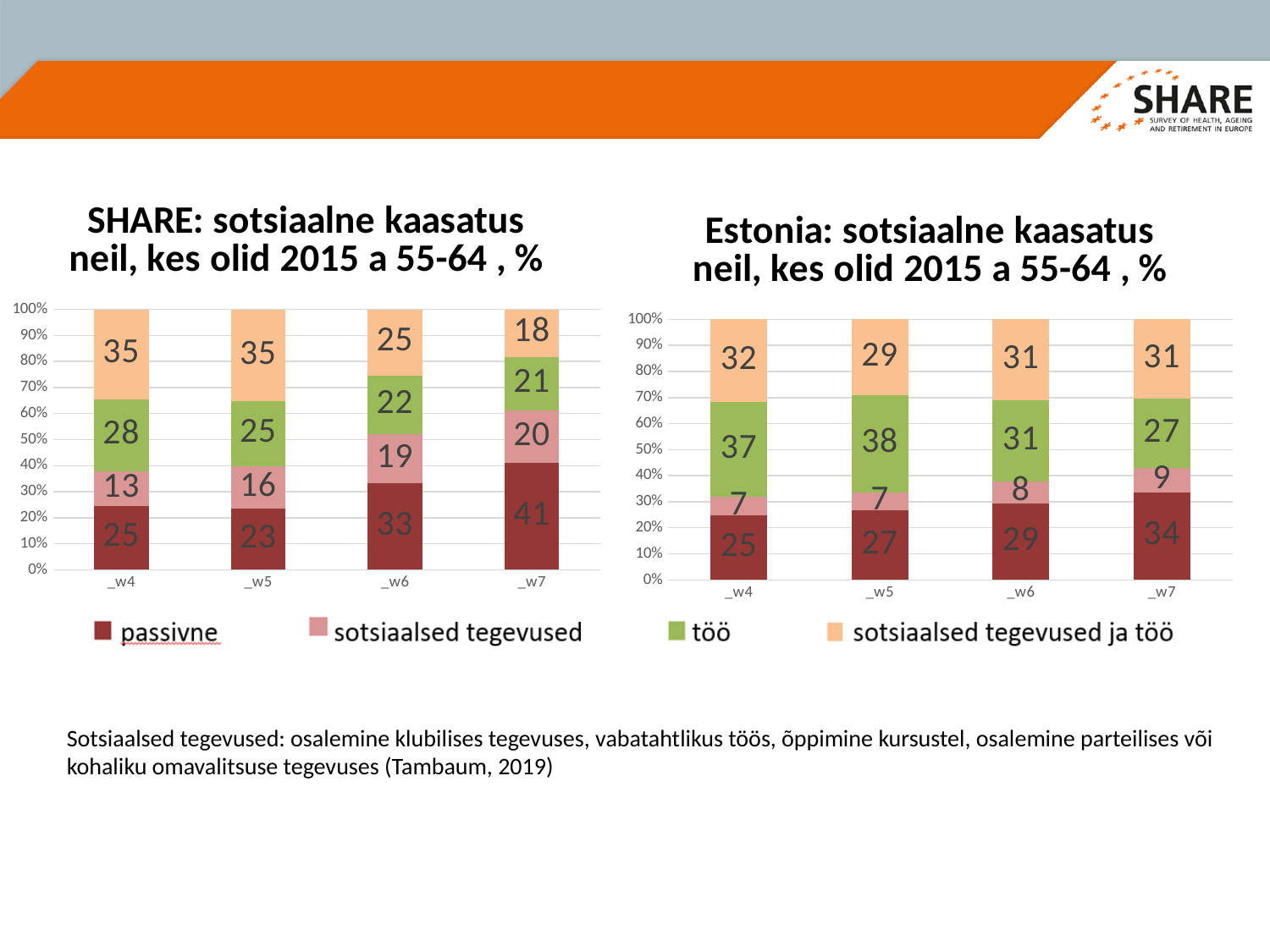
In the Estonia chart on the right, what is the value for töö at _w5? 38 In the SHARE chart on the left, what is the value for sotsiaalsed tegevused ja töö at _w6? 25 What kind of chart is the Estonia chart on the right? Stacked bar chart In the Estonia chart on the right, which is larger at _w4: töö or sotsiaalsed tegevused ja töö? töö In the SHARE chart on the left, at which wave is the passivne value highest? _w7 In the SHARE chart on the left, what is the value for passivne at _w7? 41 In the SHARE chart on the left, what is the difference between the passivne values at _w7 and _w4? 16 How many waves (categories) are shown on the x axis of the SHARE chart on the left? 4 In the Estonia chart on the right, what is the value for sotsiaalsed tegevused at _w7? 9 How many series does the legend list for the charts? 4 In the SHARE chart on the left, does the passivne value rise or fall from _w5 to _w7? Rise In the Estonia chart on the right, at which wave is the töö value lowest? _w7